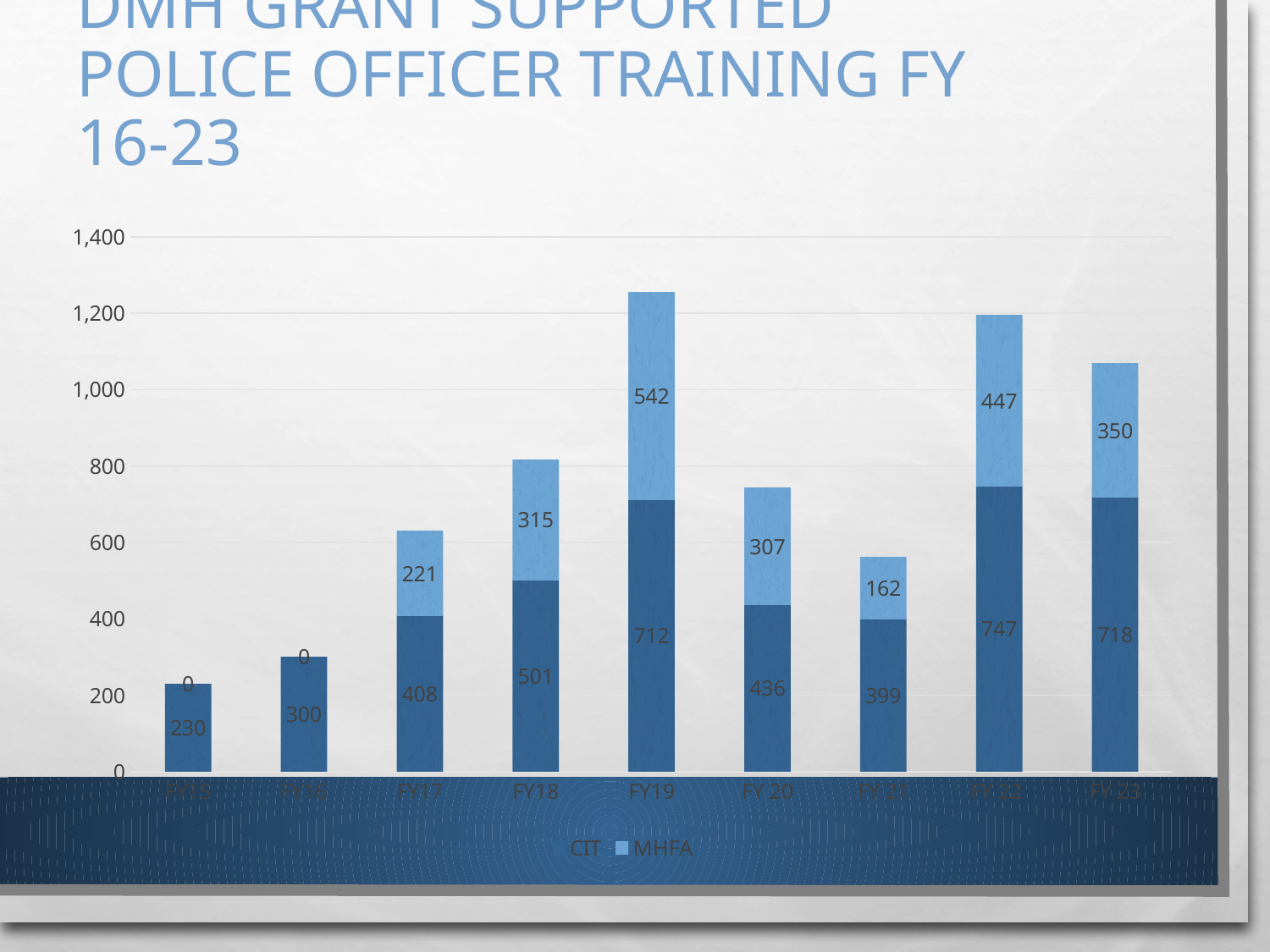
How many series does the legend list? 2 What is the CIT value for FY19? 712 How many fiscal years are shown on the x axis? 9 What is the MHFA value for FY 22? 447 Which is larger, the MHFA value for FY18 or the MHFA value for FY 20? FY18 What is the total of the stacked bar for FY 23? 1,068 What is the MHFA value for FY15? 0 Is the total stacked value for FY19 greater or less than 1,200? greater Which fiscal year has the lowest CIT value? FY15 What is the difference between the CIT values for FY 22 and FY 23? 29 Which fiscal year has the highest MHFA value? FY19 What kind of chart is shown on the slide? Stacked bar chart